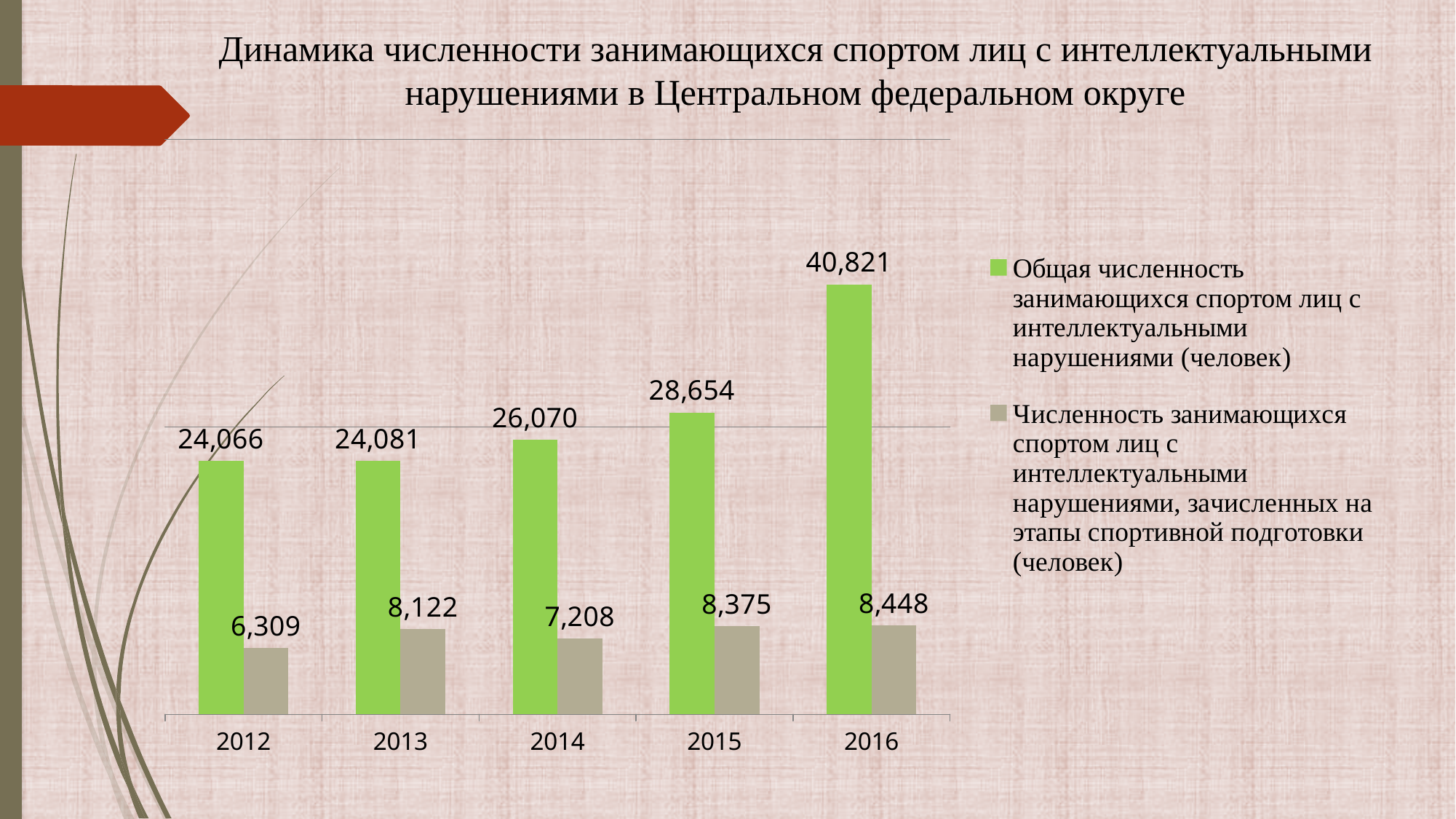
Which is larger: the grey series value for 2013 or for 2014? 2013 What is the value of the green series (Общая численность занимающихся спортом лиц с интеллектуальными нарушениями) for 2016? 40,821 How many series does the legend list? 2 In which year is the green series (Общая численность) highest? 2016 What is the total number of persons with intellectual disabilities engaged in sport (green series) in 2014? 26,070 In which year is the grey series (зачисленных на этапы спортивной подготовки) lowest? 2012 By how much did the green series (Общая численность) increase from 2015 to 2016? 12,167 What is the value of the grey series (Численность занимающихся спортом лиц с интеллектуальными нарушениями, зачисленных на этапы спортивной подготовки) for 2012? 6,309 What type of chart is shown on the slide? Bar chart How many years are shown on the x axis of the chart? 5 Does the green series (Общая численность) rise or fall from 2012 to 2016? Rises What is the difference between the grey series values for 2016 and 2012? 2,139